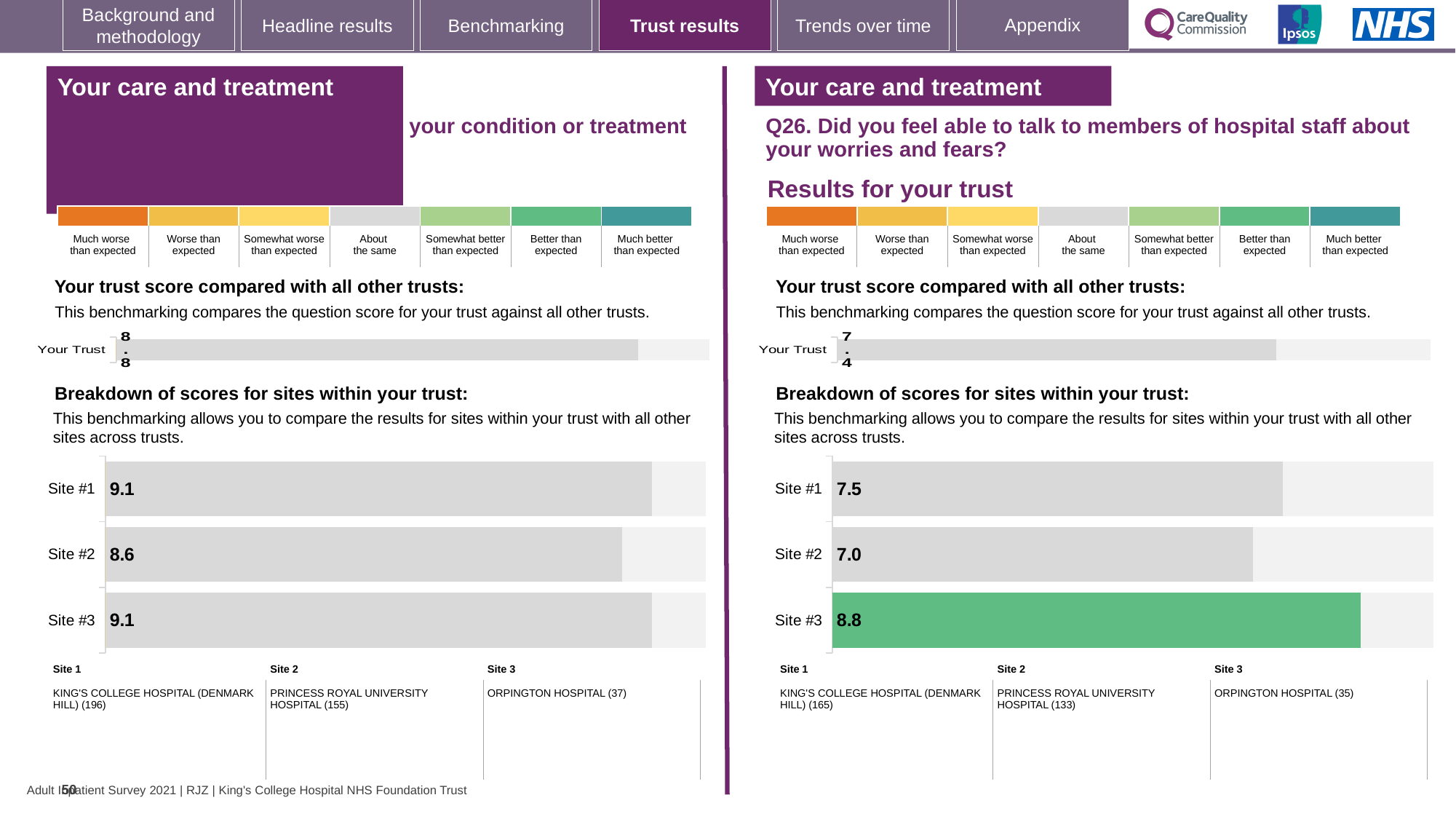
On the left-hand chart, what is the score for Site #2? 8.6 How many sites are shown in the site breakdown chart on the right-hand side (Q26)? 3 What kind of chart is used for the breakdown of scores for sites on the right-hand side (Q26)? Bar chart On the right-hand chart (Q26), what is the score for Site #1? 7.5 On the right-hand chart (Q26), what is the difference between the Site #3 score and the Site #2 score? 1.8 On the left-hand chart, what is the difference between the Site #1 score and the Site #2 score? 0.5 On the right-hand chart (Q26), which is larger: the score for Site #1 or the score for Site #2? Site #1 On the right-hand chart (Q26), which site's bar is coloured green? Site #3 On the left-hand chart, which site has the lowest score? Site #2 On the right-hand chart (Q26), which site has the lowest score? Site #2 On the right-hand chart (Q26), which site has the highest score? Site #3 On the right-hand chart (Q26), what is the score for Site #3? 8.8